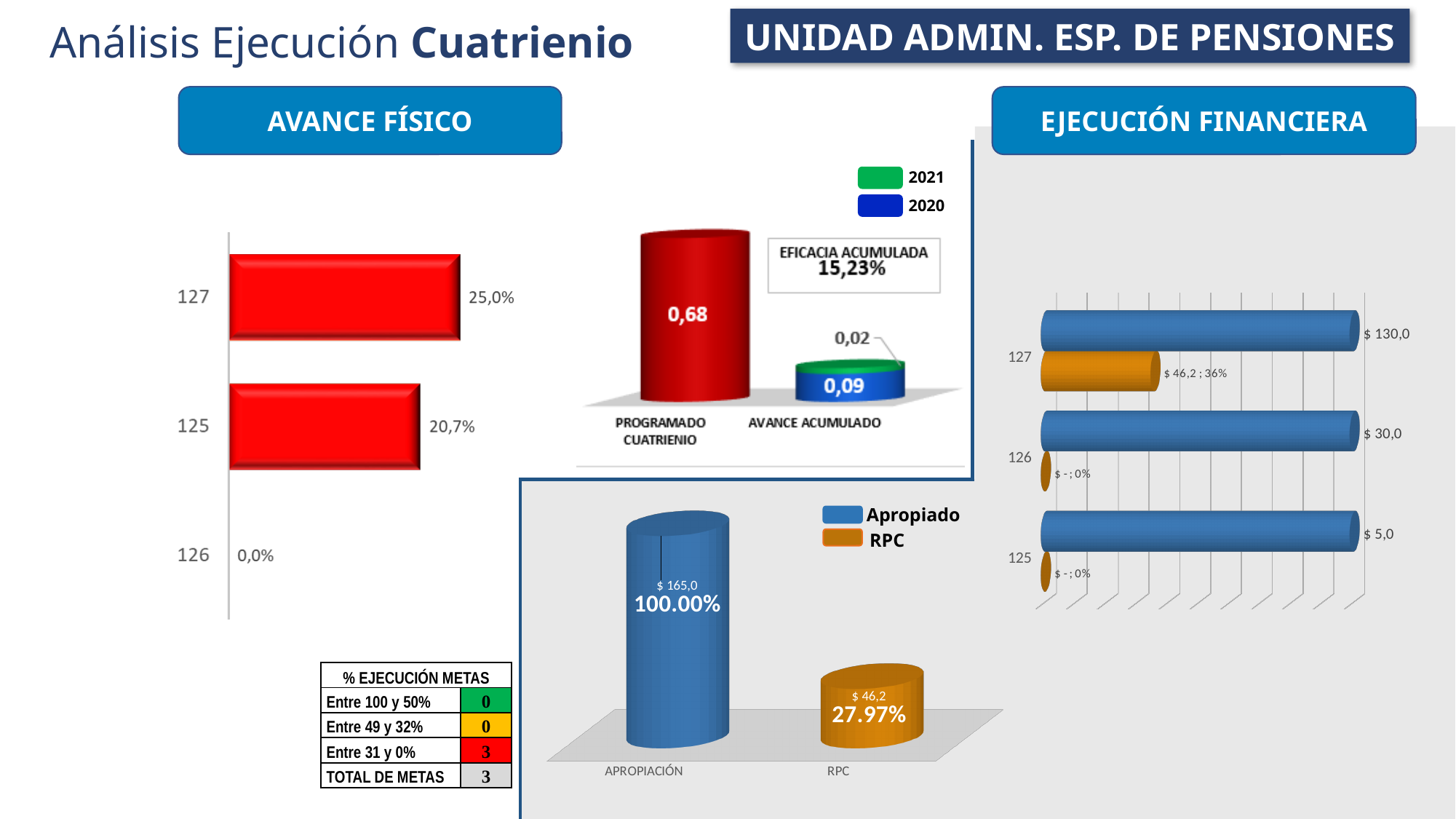
In the red horizontal bar chart on the left under AVANCE FÍSICO, what is the value for category 125? 20,7% In the red horizontal bar chart on the left under AVANCE FÍSICO, what is the difference between the values for 127 and 125? 4,3% In the 3D cylinder chart in the top middle, what is the value for PROGRAMADO CUATRIENIO? 0,68 In the 3D cylinder chart in the top middle, how many entries does the legend list? 2 In the bottom middle chart with APROPIACIÓN and RPC, what dollar value is shown for APROPIACIÓN? $ 165,0 In the horizontal bar chart on the right under EJECUCIÓN FINANCIERA, which category has the highest Apropiado value? 127 In the bottom middle chart with APROPIACIÓN and RPC, what percentage is shown for RPC? 27.97% In the red horizontal bar chart on the left under AVANCE FÍSICO, which category has the lowest value? 126 In the red horizontal bar chart on the left under AVANCE FÍSICO, how many categories are shown? 3 In the horizontal bar chart on the right under EJECUCIÓN FINANCIERA, what is the Apropiado value for category 126? $ 30,0 In the 3D cylinder chart in the top middle, what is the 2020 value for AVANCE ACUMULADO? 0,09 In the red horizontal bar chart on the left under AVANCE FÍSICO, what is the value for category 127? 25,0%